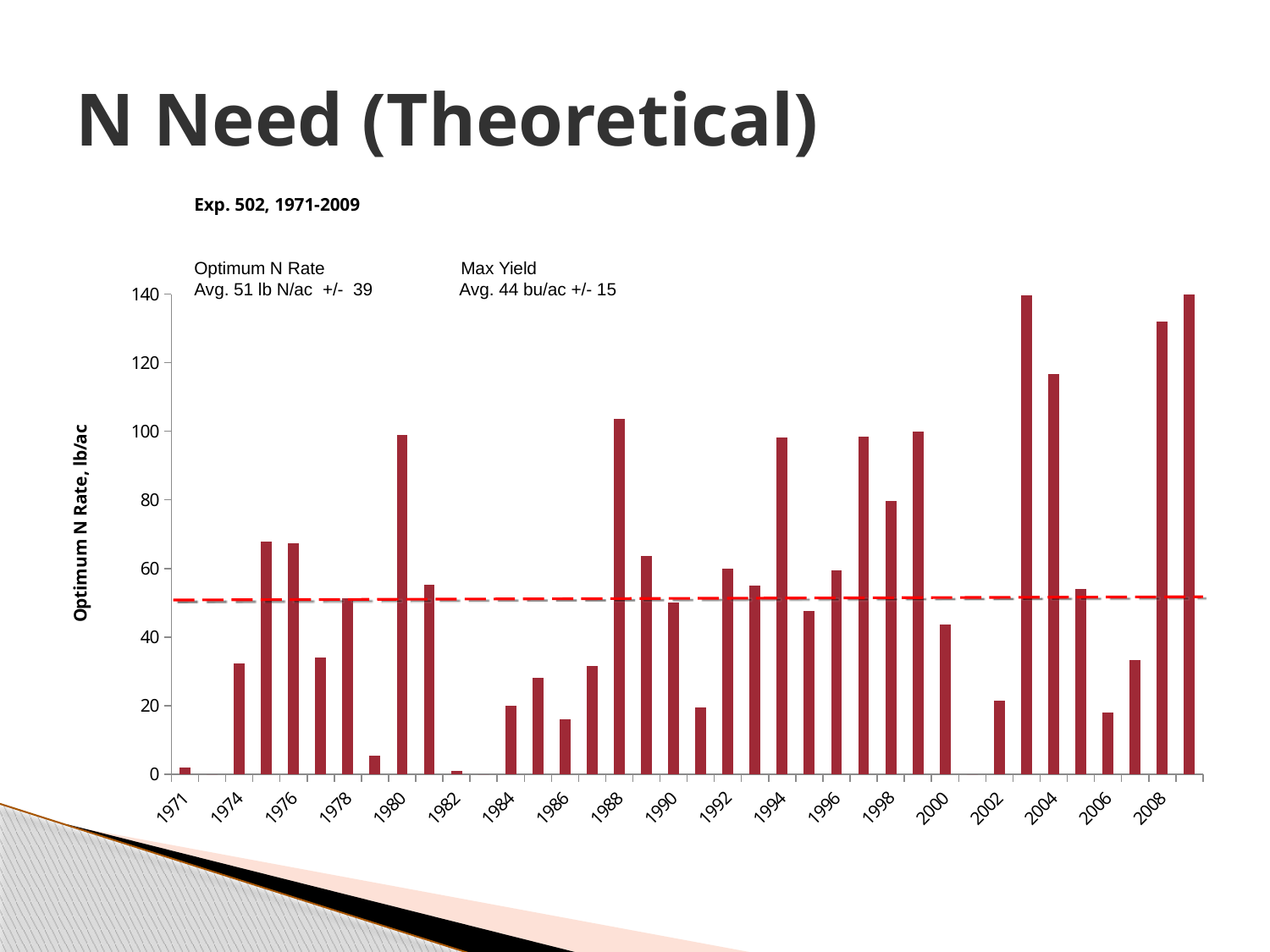
Is the value for 2002 greater or less than 40? less Is the value for 1984 greater or less than 40? less Is the value for 2004 greater or less than 100? greater What is the label on the vertical axis of the chart? Optimum N Rate, lb/ac Which has the larger value, 1980 or 1982? 1980 Which has the larger value, 2004 or 2006? 2004 What kind of chart is shown on the slide? bar chart What average Optimum N Rate is stated in the text above the chart? 51 lb N/ac